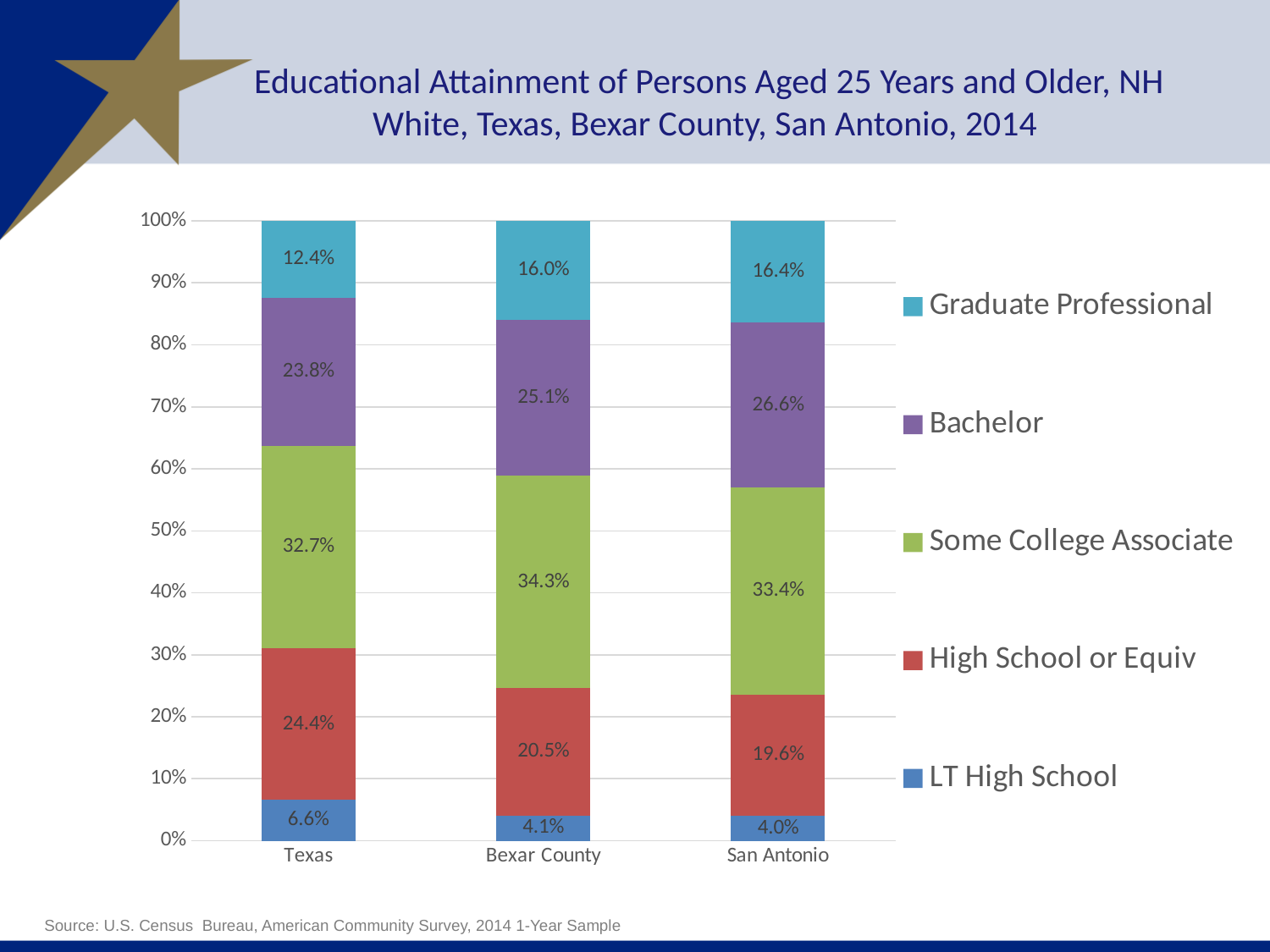
Which geography has the lowest Graduate Professional share? Texas What is the difference in LT High School share between Texas and Bexar County? 2.5 percentage points Which has a larger High School or Equiv share, Texas or San Antonio? Texas What is the Graduate Professional value for San Antonio? 16.4% What kind of chart is shown on the slide? Stacked bar chart What percentage of the Texas bar is Bachelor? 23.8% How many series does the legend list? 5 What is the LT High School value for Texas? 6.6% What is the difference in Graduate Professional share between San Antonio and Texas? 4.0 percentage points What is the High School or Equiv value for Bexar County? 20.5% Which geography has the highest Some College Associate share? Bexar County How many geographies are shown on the x axis? 3